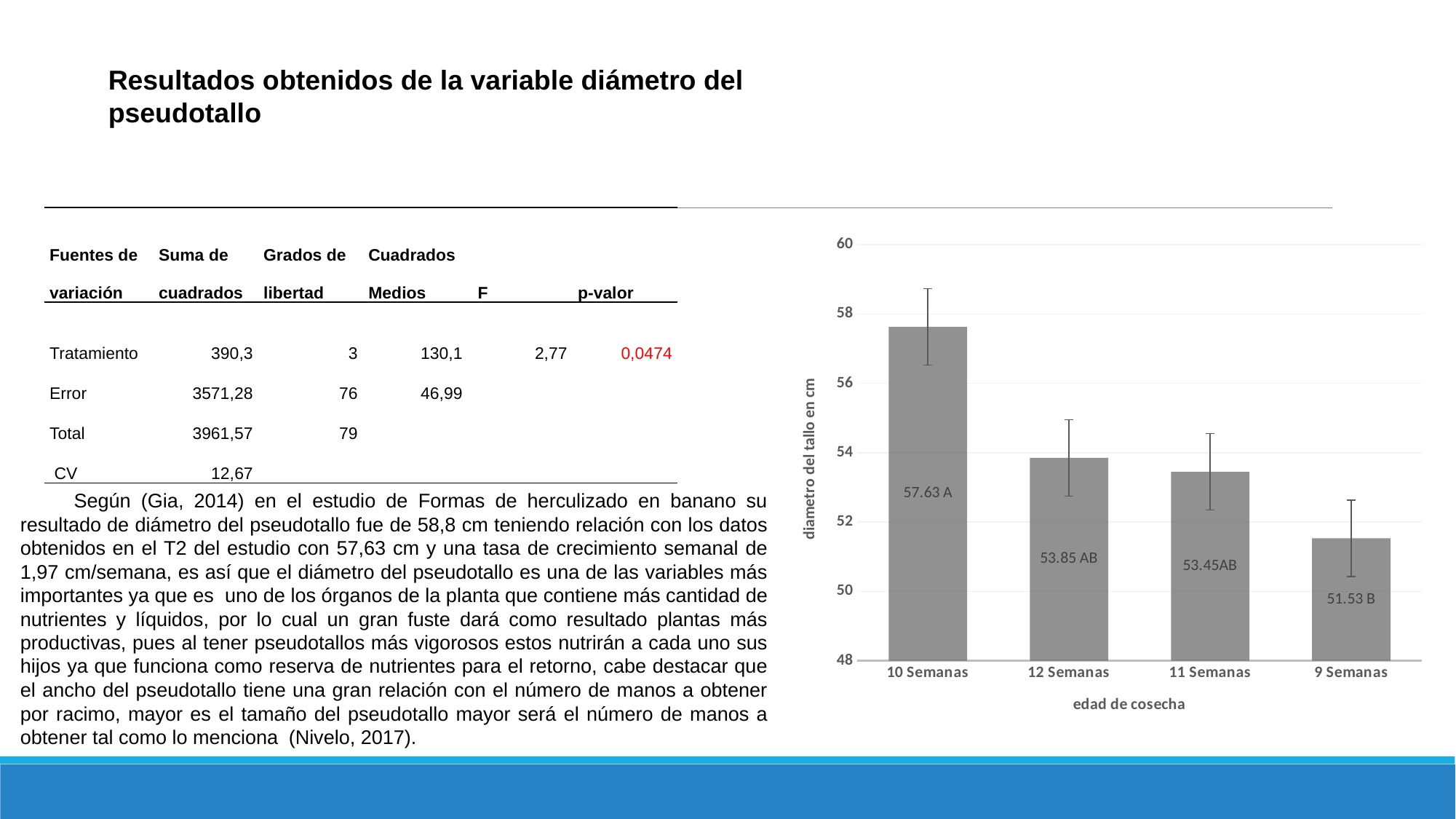
Which harvest age has the lowest diameter? 9 Semanas What is the title of the y axis? diametro del tallo en cm What is the value for 10 Semanas? 57.63 How many bars are shown in the chart? 4 Which harvest age has the highest diameter? 10 Semanas Is the value for 10 Semanas greater or less than 56? greater What data label is printed on the bar for 9 Semanas? 51.53 B Which is larger, the value for 12 Semanas or 11 Semanas? 12 Semanas What is the difference between the values for 10 Semanas and 9 Semanas? 6.10 Do the values rise or fall from left to right along the x axis? fall What is the value for 12 Semanas? 53.85 What kind of chart is shown on the slide? bar chart